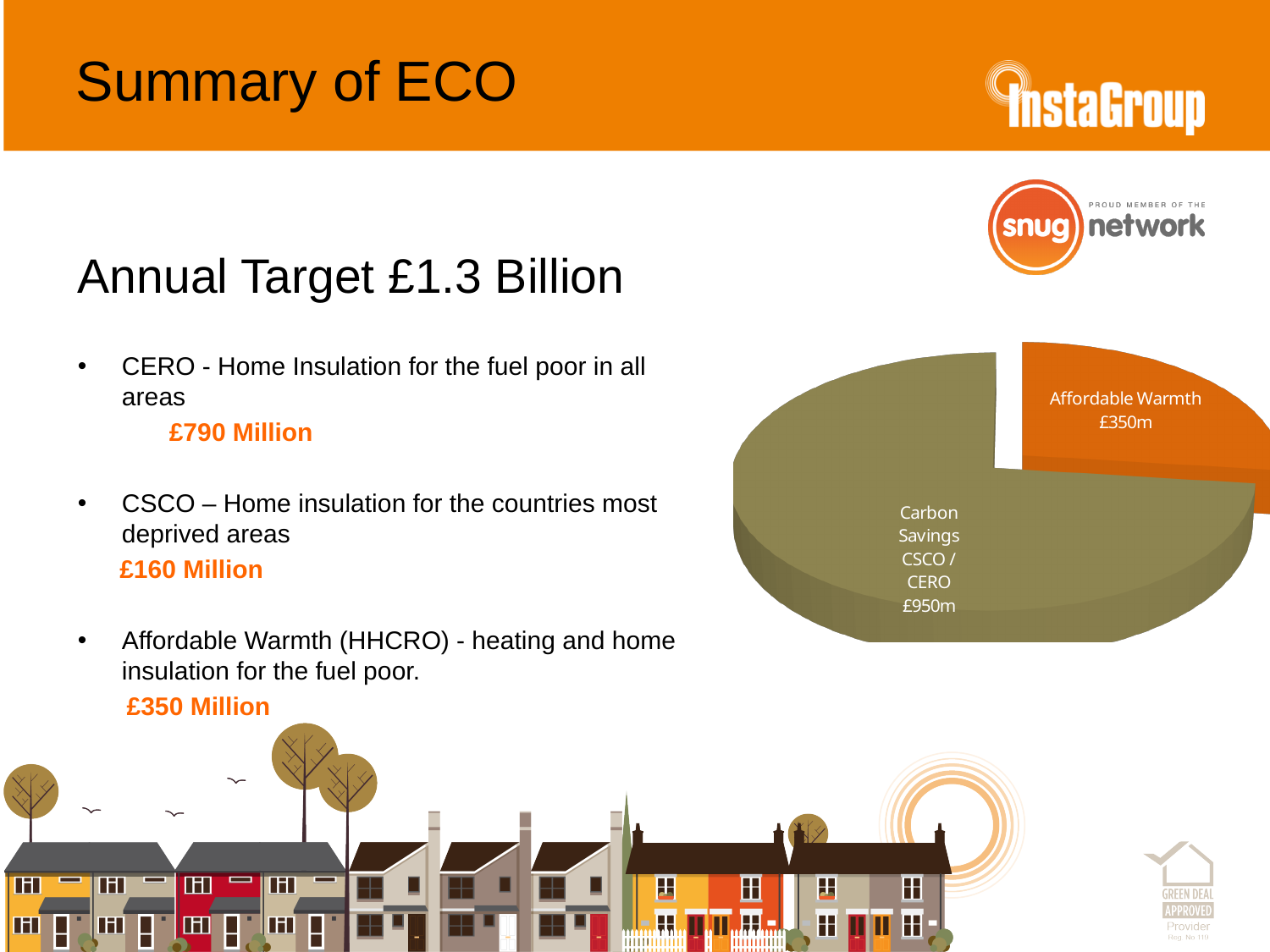
What kind of chart is shown on the slide? pie chart Which slice of the pie chart is the smallest? Affordable Warmth Which is larger in the pie chart, Affordable Warmth or Carbon Savings CSCO / CERO? Carbon Savings CSCO / CERO Which slice of the pie chart is the largest? Carbon Savings CSCO / CERO What value is shown for the Affordable Warmth slice of the pie chart? £350m What is the difference between the Carbon Savings CSCO / CERO slice and the Affordable Warmth slice? £600m Which slice of the pie chart is pulled out from the rest of the pie? Affordable Warmth How many slices does the pie chart have? 2 What value is shown for the Carbon Savings CSCO / CERO slice of the pie chart? £950m What is the total of the two slices in the pie chart? £1,300m What colour is the Affordable Warmth slice of the pie chart? orange